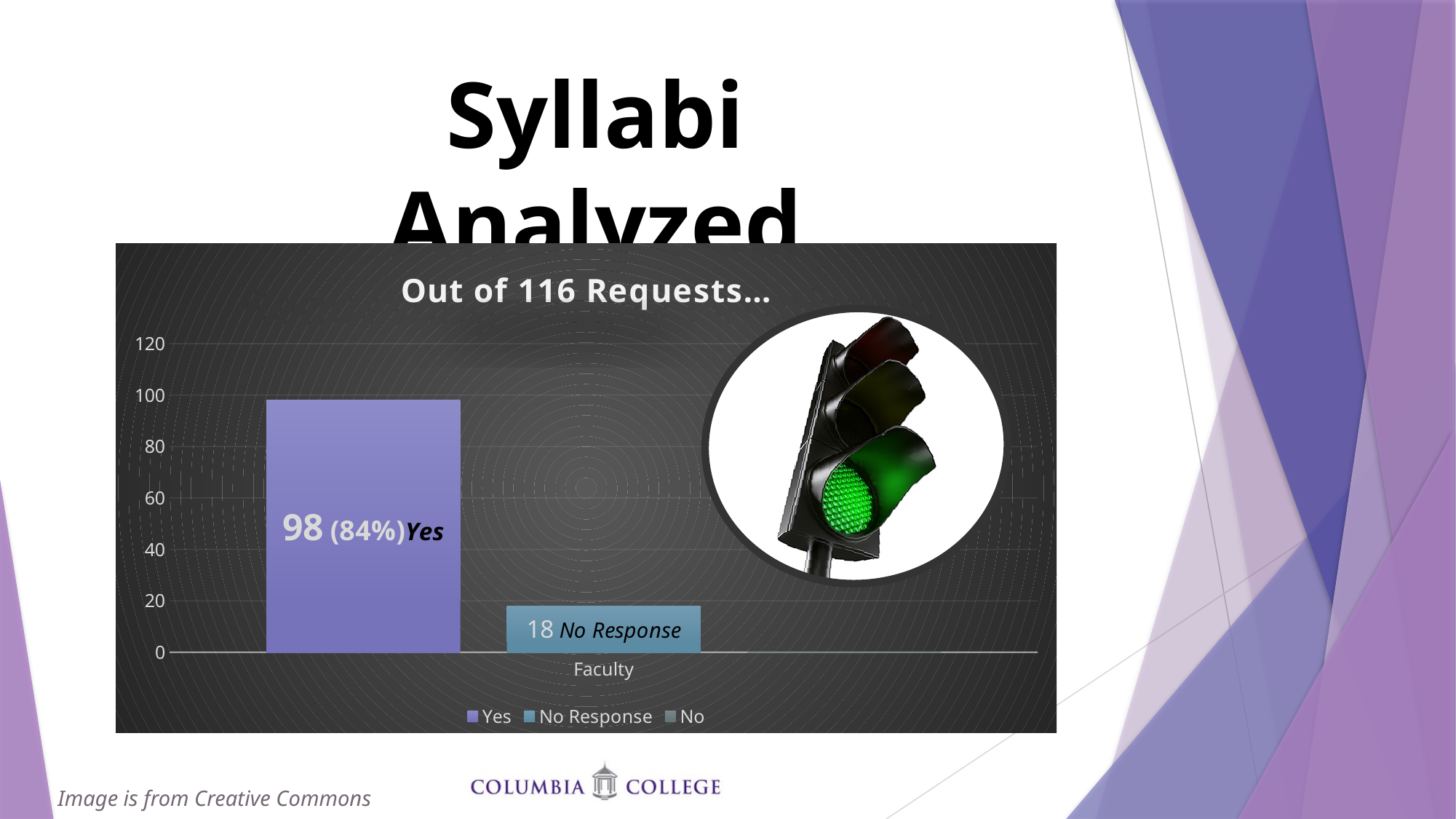
What kind of chart is shown on the slide? bar chart What percentage is shown on the Yes bar? 84% Is the value of the No Response bar greater or less than 20? less Is the value of the Yes bar greater or less than 80? greater What is the difference between the Yes value and the No Response value? 80 What is the title of the chart? Out of 116 Requests… How many series does the chart legend list? 3 What is the category label shown on the x axis? Faculty What is the value of the Yes bar for Faculty? 98 What is the value of the No Response bar for Faculty? 18 Which series has the highest value for Faculty? Yes Which is larger, the Yes value or the No Response value? Yes